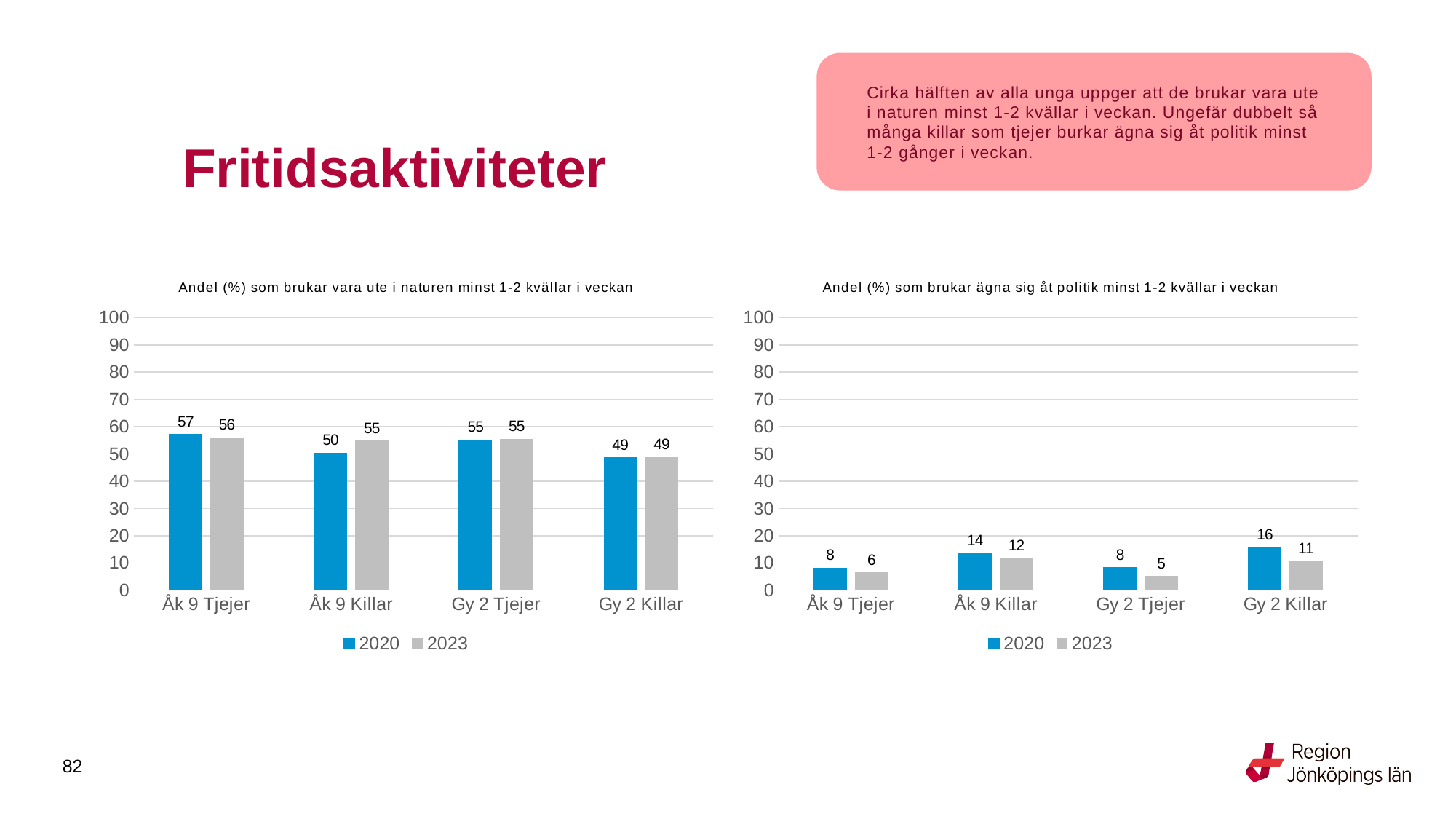
How many series does the legend of the right chart (Andel (%) som brukar ägna sig åt politik minst 1-2 kvällar i veckan) list? 2 In the right chart (Andel (%) som brukar ägna sig åt politik minst 1-2 kvällar i veckan), what is the value for Gy 2 Tjejer in 2023? 5 In the right chart (Andel (%) som brukar ägna sig åt politik minst 1-2 kvällar i veckan), what is the value for Gy 2 Killar in 2020? 16 In the left chart (Andel (%) som brukar vara ute i naturen minst 1-2 kvällar i veckan), what is the difference between the 2020 and 2023 values for Åk 9 Killar? 5 In the right chart (Andel (%) som brukar ägna sig åt politik minst 1-2 kvällar i veckan), which category has the highest value in 2020? Gy 2 Killar In the right chart (Andel (%) som brukar ägna sig åt politik minst 1-2 kvällar i veckan), what is the difference between the 2020 and 2023 values for Gy 2 Killar? 5 In the left chart (Andel (%) som brukar vara ute i naturen minst 1-2 kvällar i veckan), which category has the lowest value in 2020? Gy 2 Killar In the left chart (Andel (%) som brukar vara ute i naturen minst 1-2 kvällar i veckan), what is the value for Åk 9 Tjejer in 2020? 57 In the left chart (Andel (%) som brukar vara ute i naturen minst 1-2 kvällar i veckan), what is the value for Åk 9 Killar in 2023? 55 What kind of chart is the left chart (Andel (%) som brukar vara ute i naturen minst 1-2 kvällar i veckan)? Bar chart In the left chart (Andel (%) som brukar vara ute i naturen minst 1-2 kvällar i veckan), how many categories are shown on the x axis? 4 In the right chart (Andel (%) som brukar ägna sig åt politik minst 1-2 kvällar i veckan), is the 2023 value for Åk 9 Killar larger or smaller than the 2023 value for Gy 2 Killar? larger